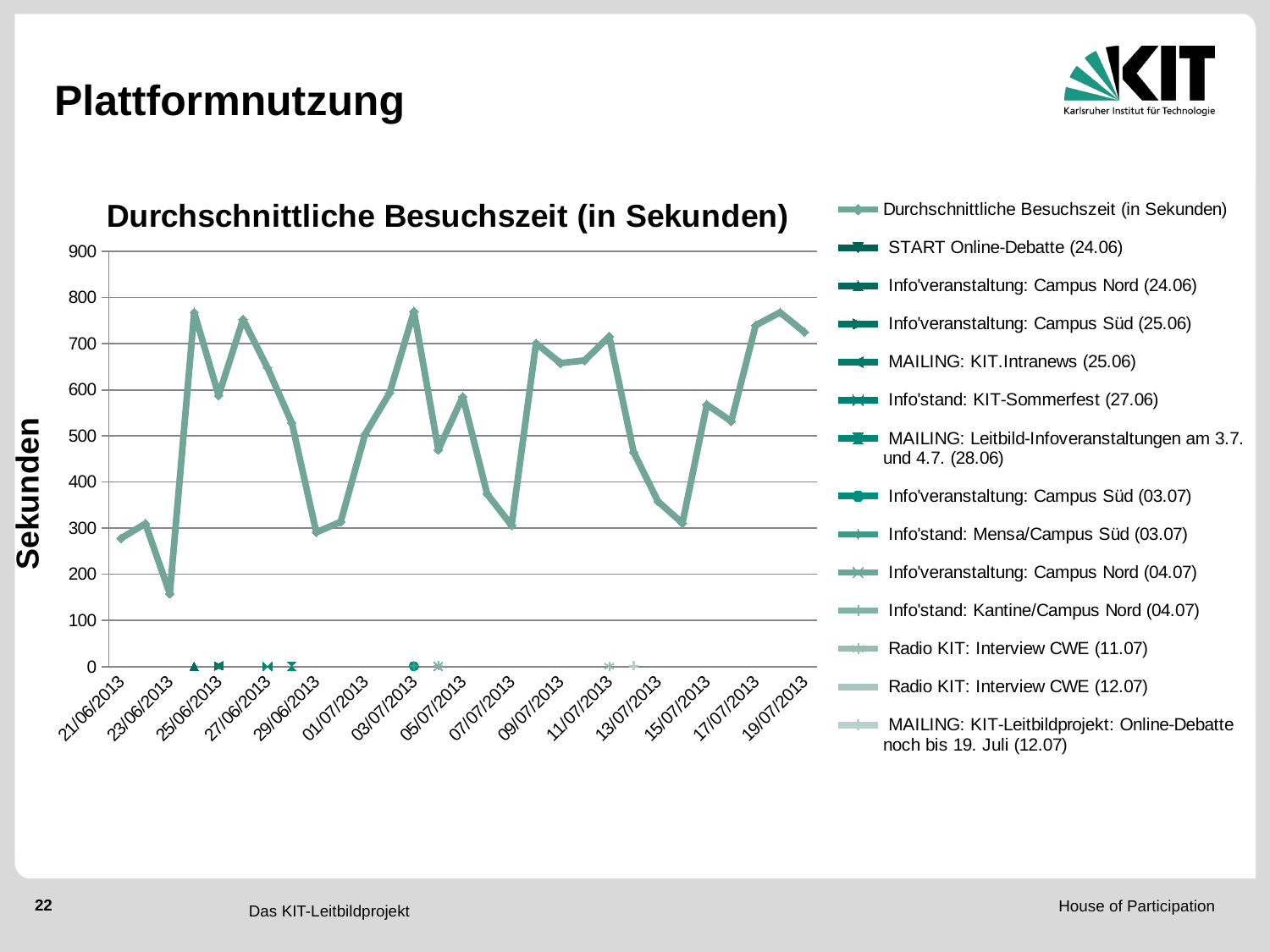
What is the title of the chart? Durchschnittliche Besuchszeit (in Sekunden) Is the value for 23/06/2013 greater or less than 200? less What label is shown on the vertical axis of the chart? Sekunden Which date has the lowest average visit time on the chart? 23/06/2013 Is the value for 13/07/2013 greater or less than 400? less Which has the larger value, 13/07/2013 or 17/07/2013? 17/07/2013 How many date labels are shown along the x axis? 15 How many entries does the chart legend list? 14 Which has the larger value, 23/06/2013 or 25/06/2013? 25/06/2013 Is the value for 25/06/2013 greater or less than 500? greater What kind of chart is shown on the slide? line chart